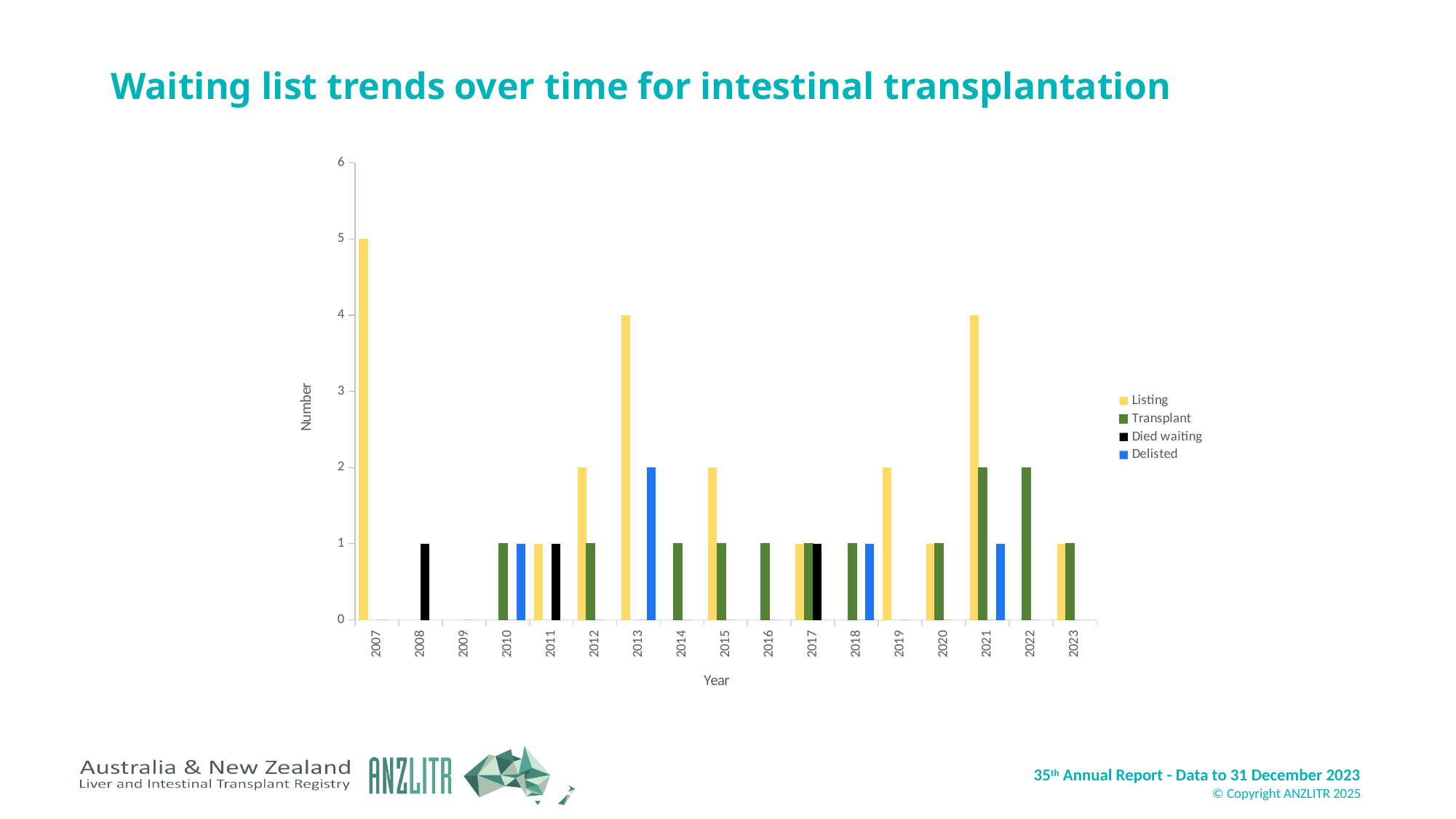
What kind of chart is shown on the slide? Bar chart Which series is shown in black in the legend? Died waiting What is the difference between the Listing value and the Delisted value in 2013? 2 Which is larger in 2021, the Listing value or the Transplant value? Listing Is the Listing value for 2007 greater or less than 4? greater What is the value of the Delisted series in 2013? 2 How many years are shown on the x axis? 17 What is the value of the Transplant series in 2022? 2 How many series does the legend list? 4 What is the label of the y axis? Number What is the value of the Listing series in 2007? 5 In which year is the Listing value highest? 2007